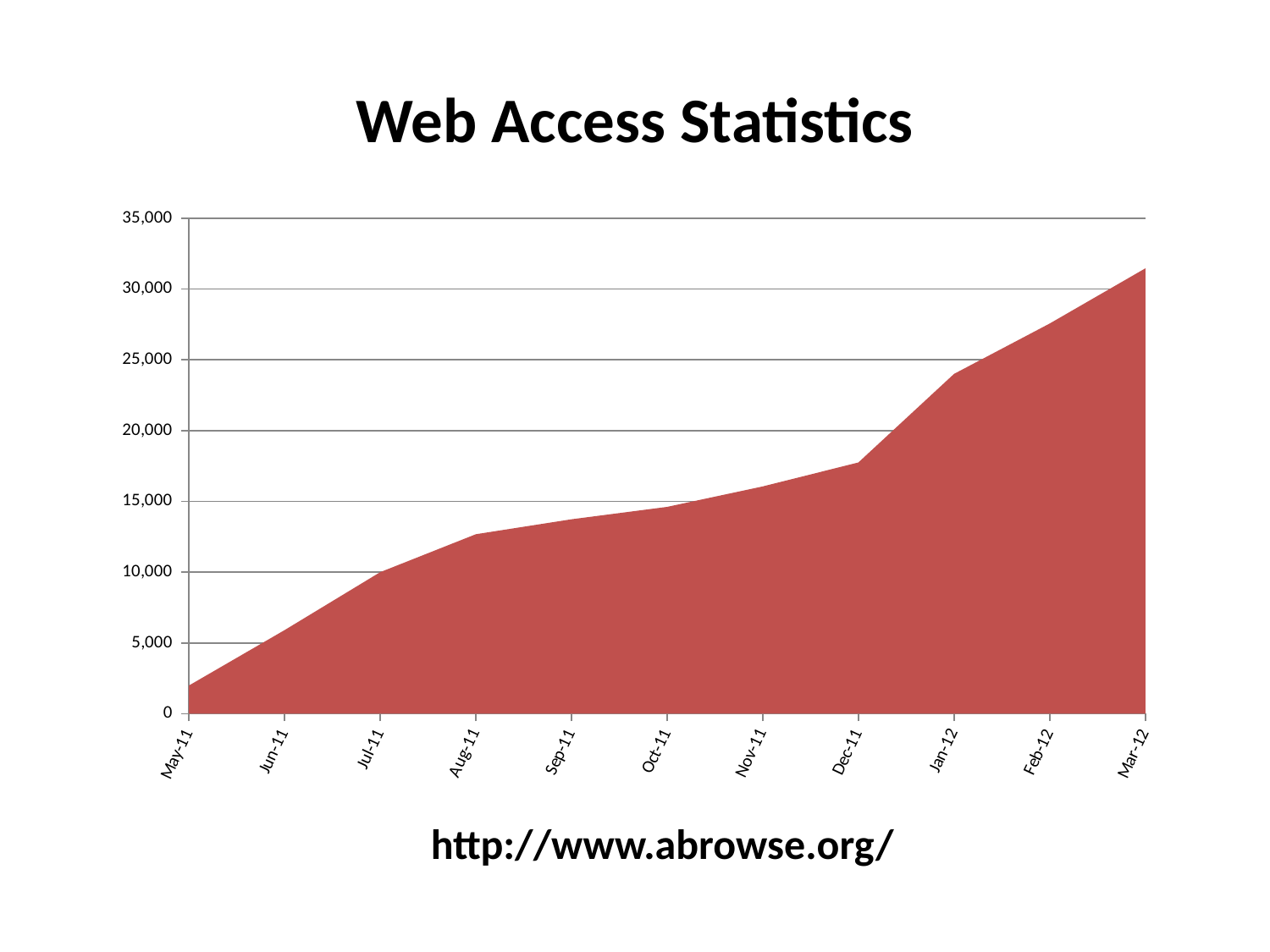
Which month has the highest value? Mar-12 Do the values rise or fall from May-11 to Mar-12? rise Which is larger, the value for Aug-11 or the value for Feb-12? Feb-12 Which month has the lowest value? May-11 Is the value for Mar-12 greater or less than 30,000? greater Is the value for Dec-11 greater or less than 20,000? less Is the value for Jan-12 greater or less than 20,000? greater What kind of chart is shown on the slide? area chart What is the highest value shown on the y axis? 35,000 How many months are plotted along the x axis? 11 What is the title of the chart? Web Access Statistics